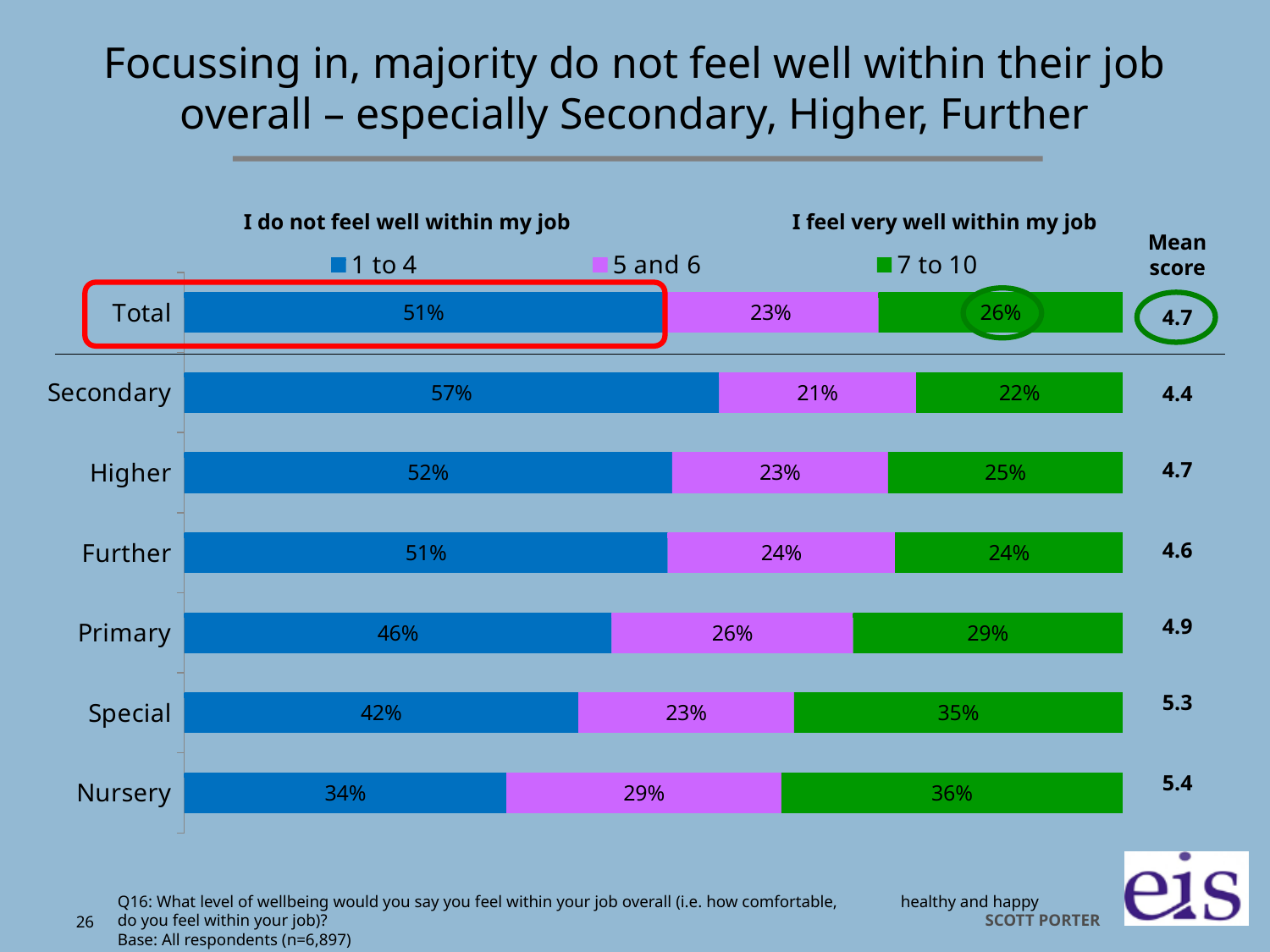
Which category has the lowest 7 to 10 percentage? Secondary What percentage of Nursery respondents gave a score of 7 to 10? 36% What is the mean score shown for Nursery? 5.4 How many categories are shown on the chart, including Total? 7 Which category has the highest 1 to 4 percentage? Secondary How many series does the legend list? 3 What percentage of Secondary respondents gave a score of 1 to 4? 57% What is the total of the three segments in the Total bar? 100% What kind of chart is shown on the slide? Stacked bar chart What is the 5 and 6 value for Primary? 26% Which is larger: the 7 to 10 value for Special or the 7 to 10 value for Higher? Special What is the difference between the 1 to 4 percentages for Secondary and Nursery? 23%